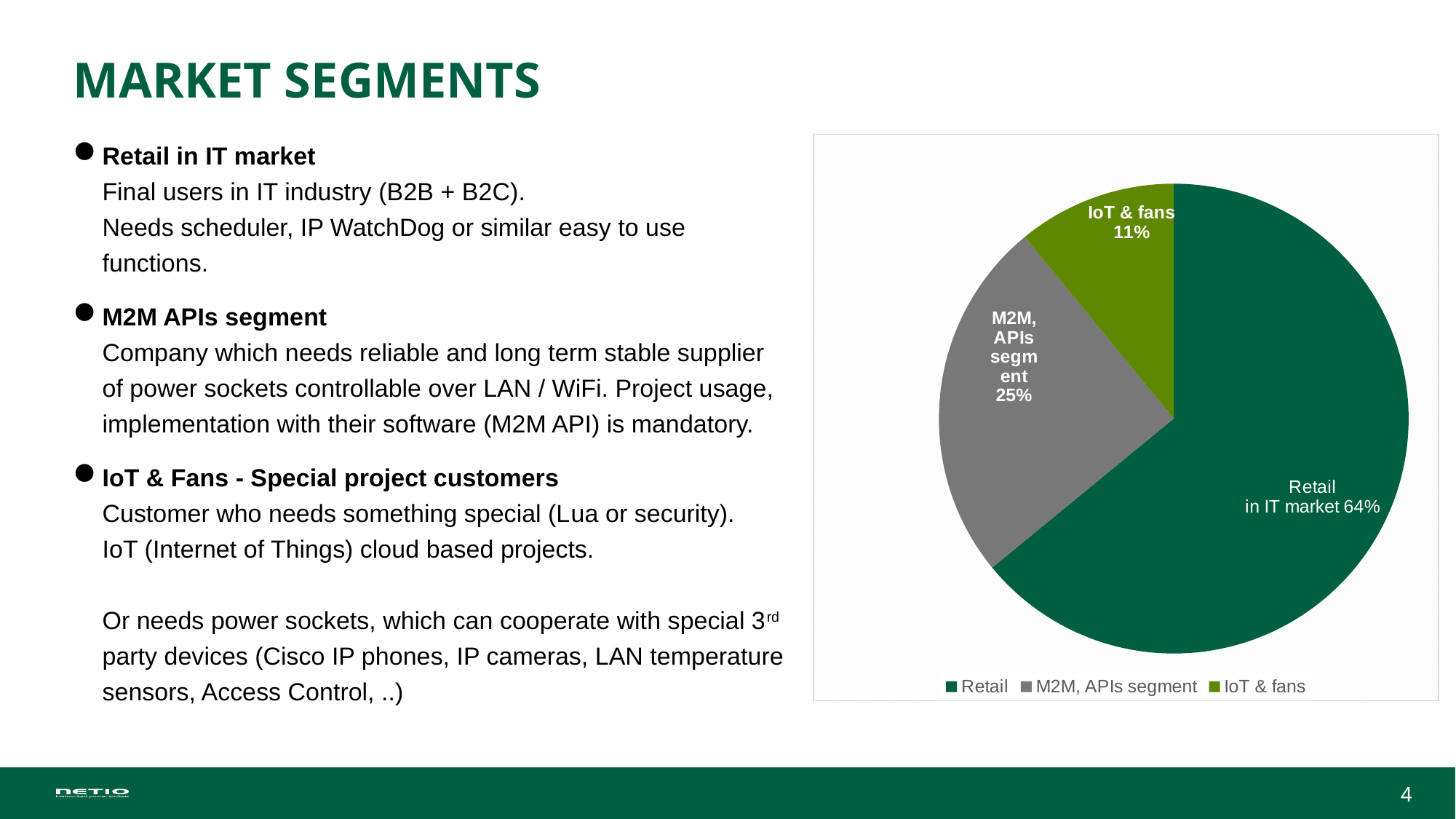
How many slices does the pie chart have? 3 What share of the pie does the M2M, APIs segment have? 25% Which is larger, the M2M, APIs segment share or the IoT & fans share? M2M, APIs segment What share of the pie does Retail in IT market have? 64% What colour is the Retail slice in the pie chart? dark green What kind of chart is shown on the slide? pie chart Which segment has the largest share of the pie? Retail What share of the pie does IoT & fans have? 11% Which segment has the smallest share of the pie? IoT & fans What is the difference in percentage points between the Retail share and the M2M, APIs segment share? 39 How many entries does the legend list? 3 What is the difference in percentage points between the M2M, APIs segment share and the IoT & fans share? 14